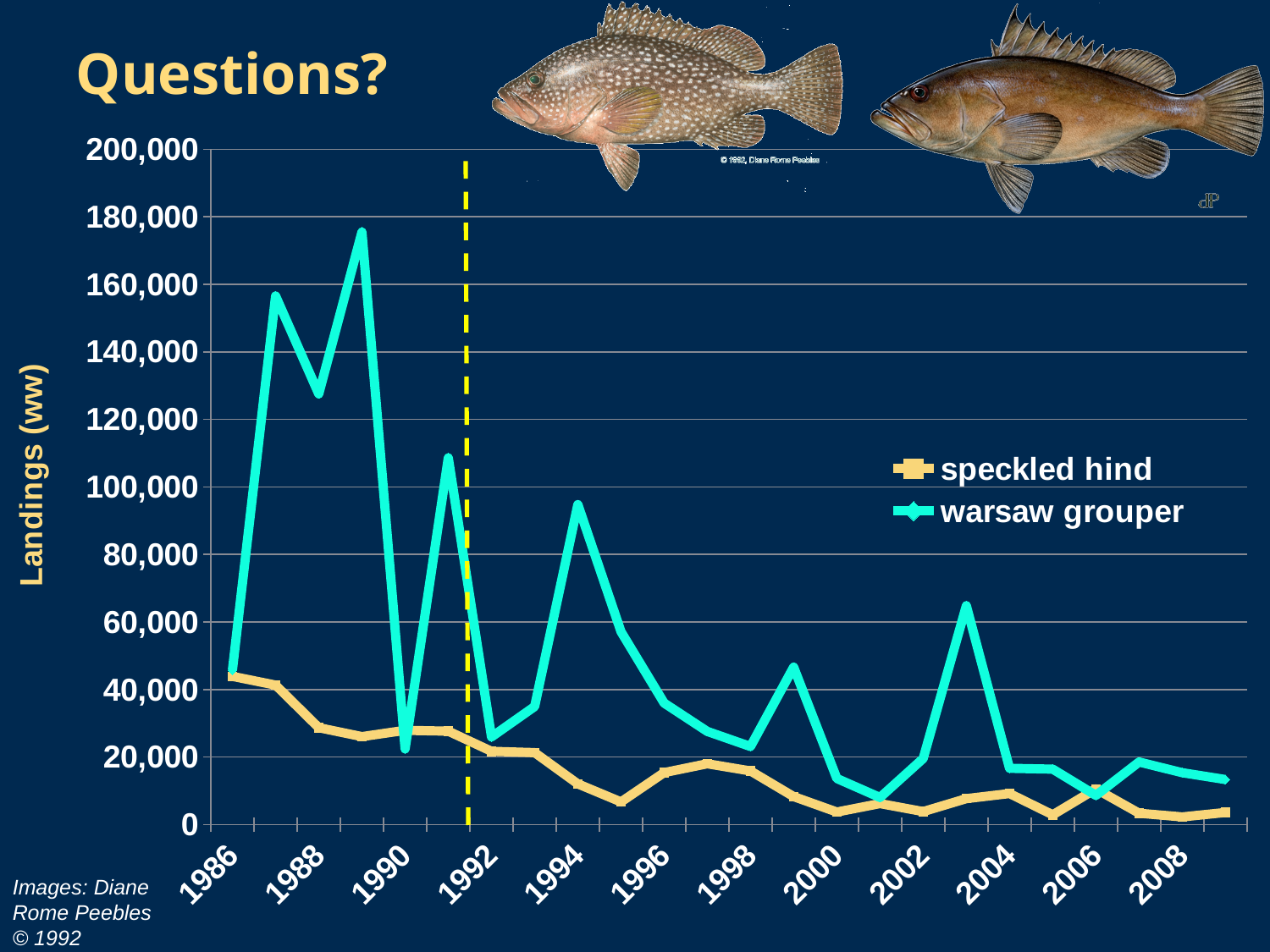
Is the value for warsaw grouper in 1994 greater or less than 80,000? greater In which year does the warsaw grouper series reach its highest value? 1989 Is the value for speckled hind in 2008 greater or less than 20,000? less Is the value for speckled hind in 1986 greater or less than 60,000? less Which series has the larger value in 1987, speckled hind or warsaw grouper? warsaw grouper Overall, do the speckled hind values rise or fall from 1986 to 2008? fall Which two series are listed in the legend? speckled hind and warsaw grouper Which series has the larger value in 2008, speckled hind or warsaw grouper? warsaw grouper What is the label on the y axis? Landings (ww) How many series does the legend list? 2 What kind of chart is shown on the slide? line chart